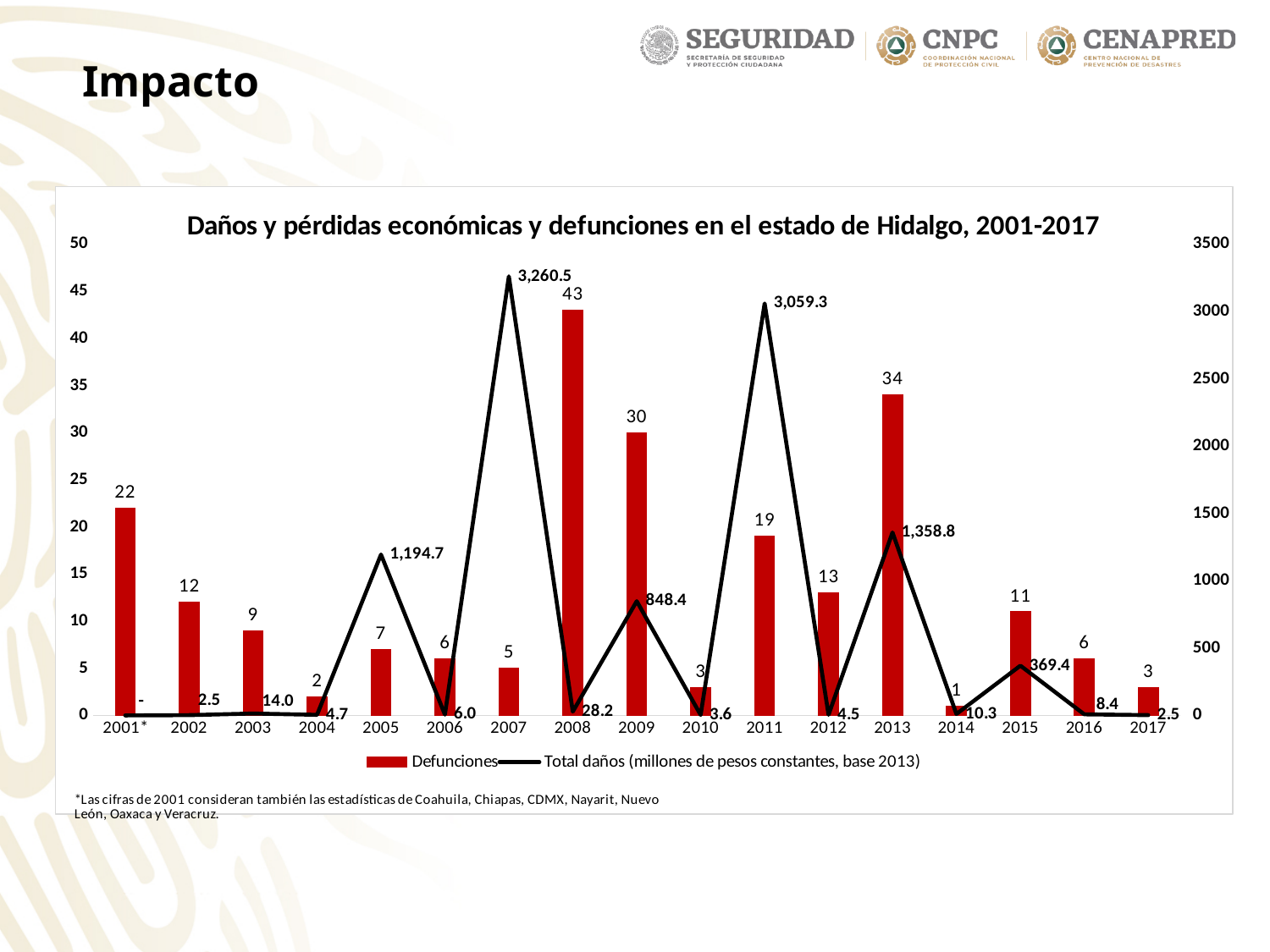
What is the Total daños value for 2015? 369.4 Which year has a higher Total daños value, 2007 or 2011? 2007 What is the title of the chart? Daños y pérdidas económicas y defunciones en el estado de Hidalgo, 2001-2017 What is the difference in Defunciones between 2008 and 2013? 9 What is the value of Total daños for 2007? 3,260.5 What is the difference in Total daños between 2011 and 2013? 1,700.5 How many years are shown on the x axis? 17 What kind of chart is used to show Defunciones? Bar chart How many deaths (Defunciones) are shown for 2008? 43 Which year has the highest number of Defunciones? 2008 Which year has the lowest number of Defunciones? 2014 How many series does the legend list? 2